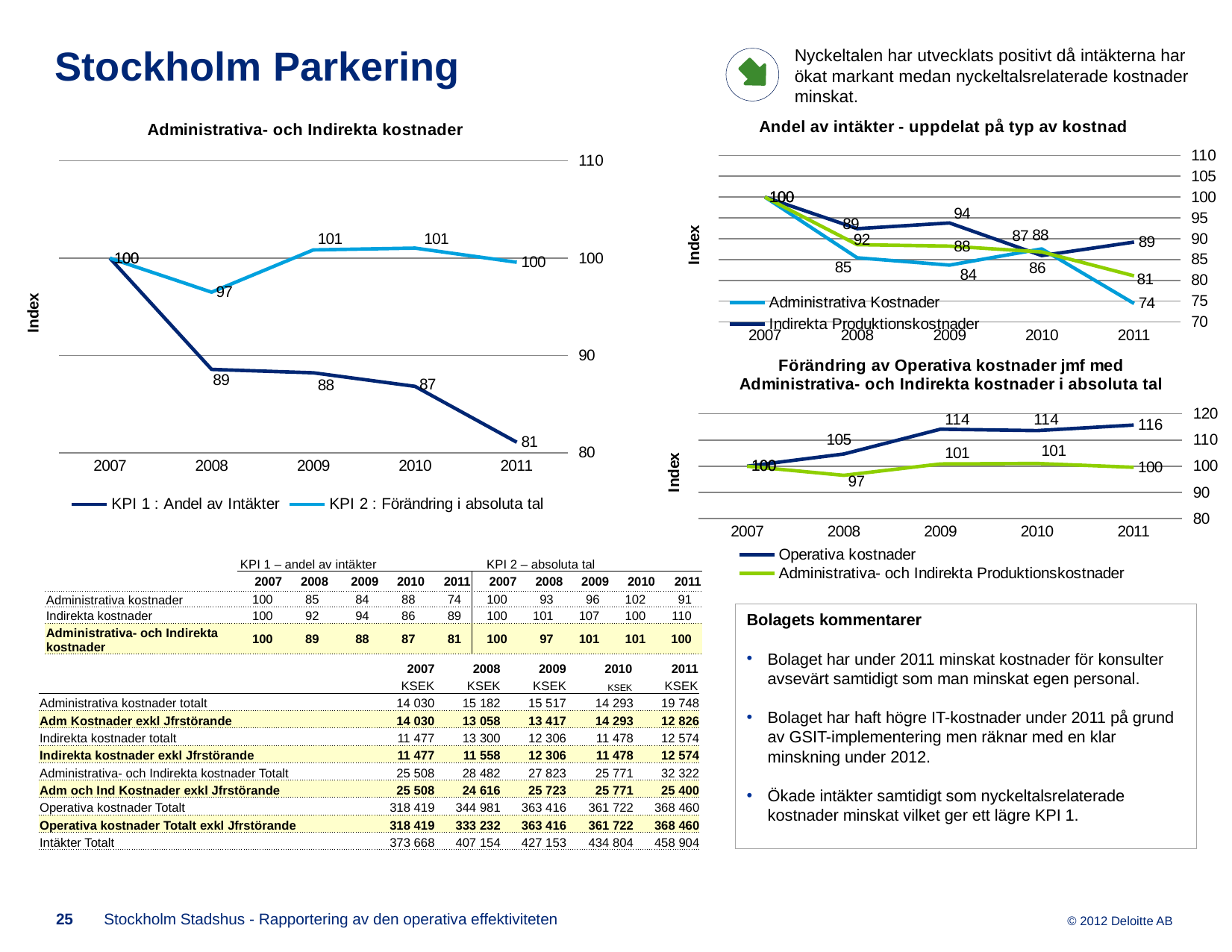
How many series does the legend of the chart 'Administrativa- och Indirekta kostnader' list? 2 What kind of chart is 'Förändring av Operativa kostnader jmf med Administrativa- och Indirekta kostnader i absoluta tal'? line chart In the chart 'Andel av intäkter - uppdelat på typ av kostnad', what is the value of Administrativa Kostnader in 2011? 74 In the chart 'Förändring av Operativa kostnader jmf med Administrativa- och Indirekta kostnader i absoluta tal', what is the difference between Operativa kostnader and Administrativa- och Indirekta Produktionskostnader in 2008? 8 In the chart 'Förändring av Operativa kostnader jmf med Administrativa- och Indirekta kostnader i absoluta tal', what is the value of Operativa kostnader in 2011? 116 In the chart 'Administrativa- och Indirekta kostnader', what is the value of KPI 2 : Förändring i absoluta tal in 2008? 97 In the chart 'Administrativa- och Indirekta kostnader', in which year is KPI 1 : Andel av Intäkter lowest? 2011 In the chart 'Administrativa- och Indirekta kostnader', does KPI 1 : Andel av Intäkter rise or fall from 2007 to 2011? fall In the chart 'Administrativa- och Indirekta kostnader', what is the value of KPI 1 : Andel av Intäkter in 2011? 81 In the chart 'Förändring av Operativa kostnader jmf med Administrativa- och Indirekta kostnader i absoluta tal', which series is higher in 2009, Operativa kostnader or Administrativa- och Indirekta Produktionskostnader? Operativa kostnader In the chart 'Administrativa- och Indirekta kostnader', what is the difference between KPI 2 and KPI 1 in 2010? 14 How many years are shown on the x axis of the chart 'Andel av intäkter - uppdelat på typ av kostnad'? 5